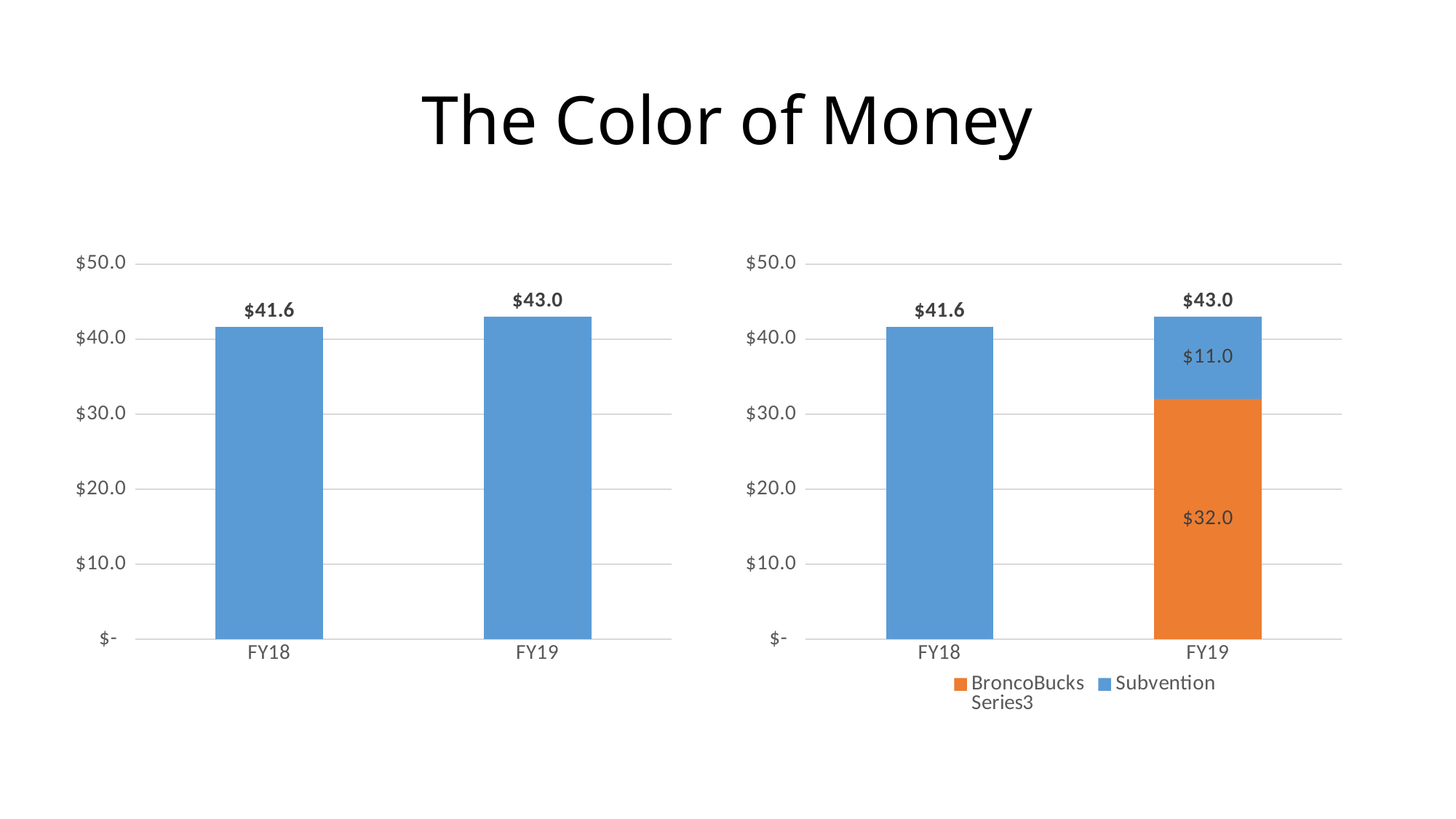
In the left chart, which category has the higher value, FY18 or FY19? FY19 In the right chart, what is the Subvention value for FY19? $11.0 In the right chart, what is the total of the stacked bar for FY19? $43.0 In the left chart, what is the value for FY19? $43.0 In the left chart, what is the difference between the FY19 and FY18 values? $1.4 What kind of chart is the left chart? Bar chart In the left chart, how many categories are shown on the x axis? 2 In the right chart, how many series does the legend list? 3 In the right chart, which colour represents BroncoBucks? Orange In the left chart, what is the value for FY18? $41.6 In the right chart, which segment of the FY19 bar is larger, BroncoBucks or Subvention? BroncoBucks In the right chart, what is the BroncoBucks value for FY19? $32.0